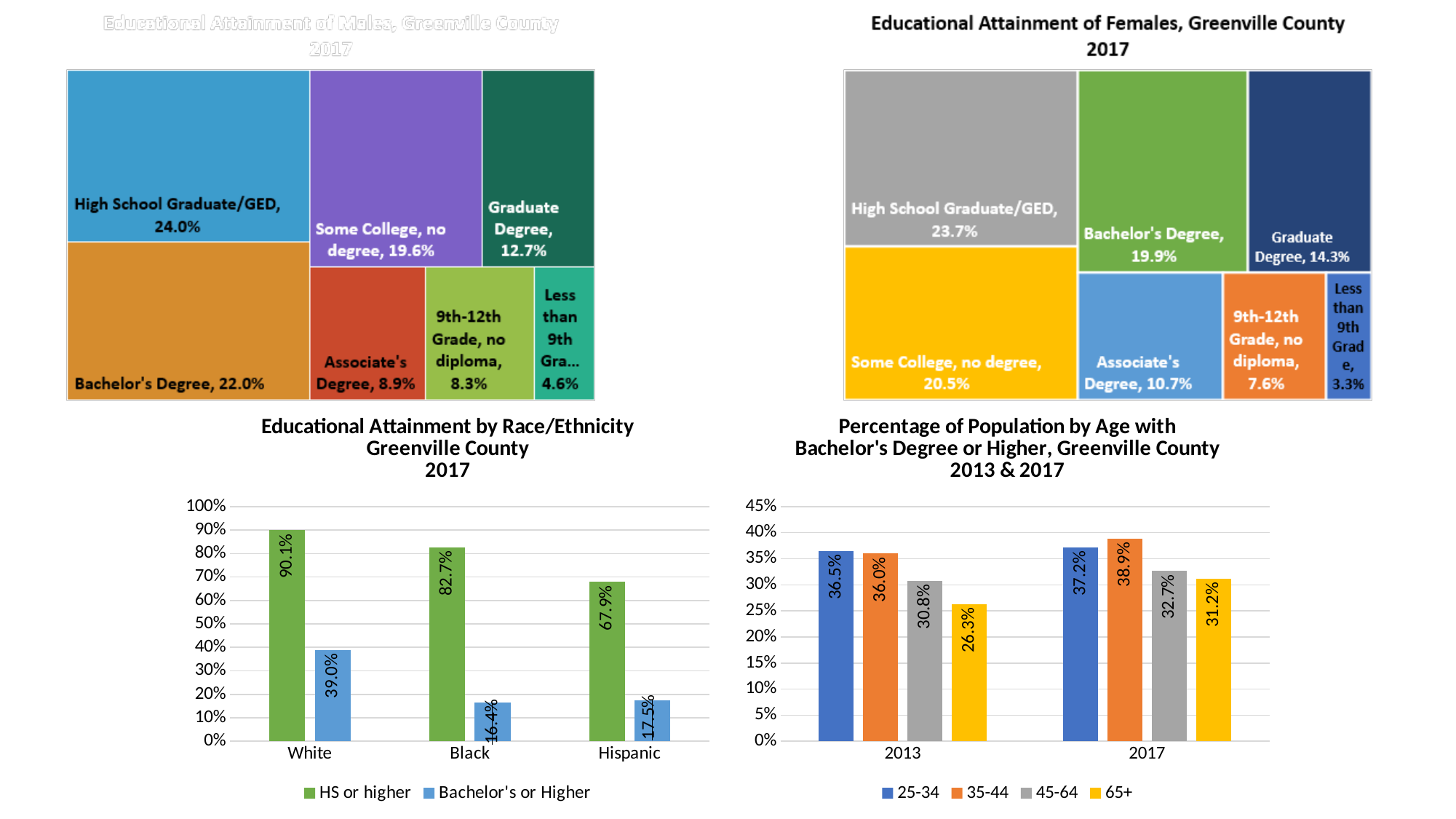
In the 'Educational Attainment of Females, Greenville County 2017' treemap, which category has the largest share? High School Graduate/GED In the 'Educational Attainment of Males, Greenville County 2017' treemap, what percentage is shown for High School Graduate/GED? 24.0% In the 'Educational Attainment by Race/Ethnicity Greenville County 2017' chart, which race/ethnicity has the lowest 'HS or higher' value? Hispanic In the 'Educational Attainment of Females, Greenville County 2017' treemap, what percentage is shown for Some College, no degree? 20.5% In the 'Educational Attainment of Males, Greenville County 2017' treemap, which category has the smallest share? Less than 9th Grade What kind of chart is the 'Educational Attainment by Race/Ethnicity Greenville County 2017' chart? Bar chart In the 'Percentage of Population by Age with Bachelor's Degree or Higher' chart, which age group has the highest value in 2017? 35-44 In the 'Percentage of Population by Age with Bachelor's Degree or Higher' chart, what is the value for the 65+ group in 2017? 31.2% In the 'Educational Attainment by Race/Ethnicity Greenville County 2017' chart, what is the 'Bachelor's or Higher' value for White? 39.0% How many series does the legend list in the 'Percentage of Population by Age with Bachelor's Degree or Higher, Greenville County 2013 & 2017' chart? 4 What is the difference between the Graduate Degree share for females (14.3%) and for males (12.7%) in the two treemaps? 1.6% In the 'Educational Attainment by Race/Ethnicity Greenville County 2017' chart, what is the difference between the 'HS or higher' and 'Bachelor's or Higher' values for Black? 66.3%